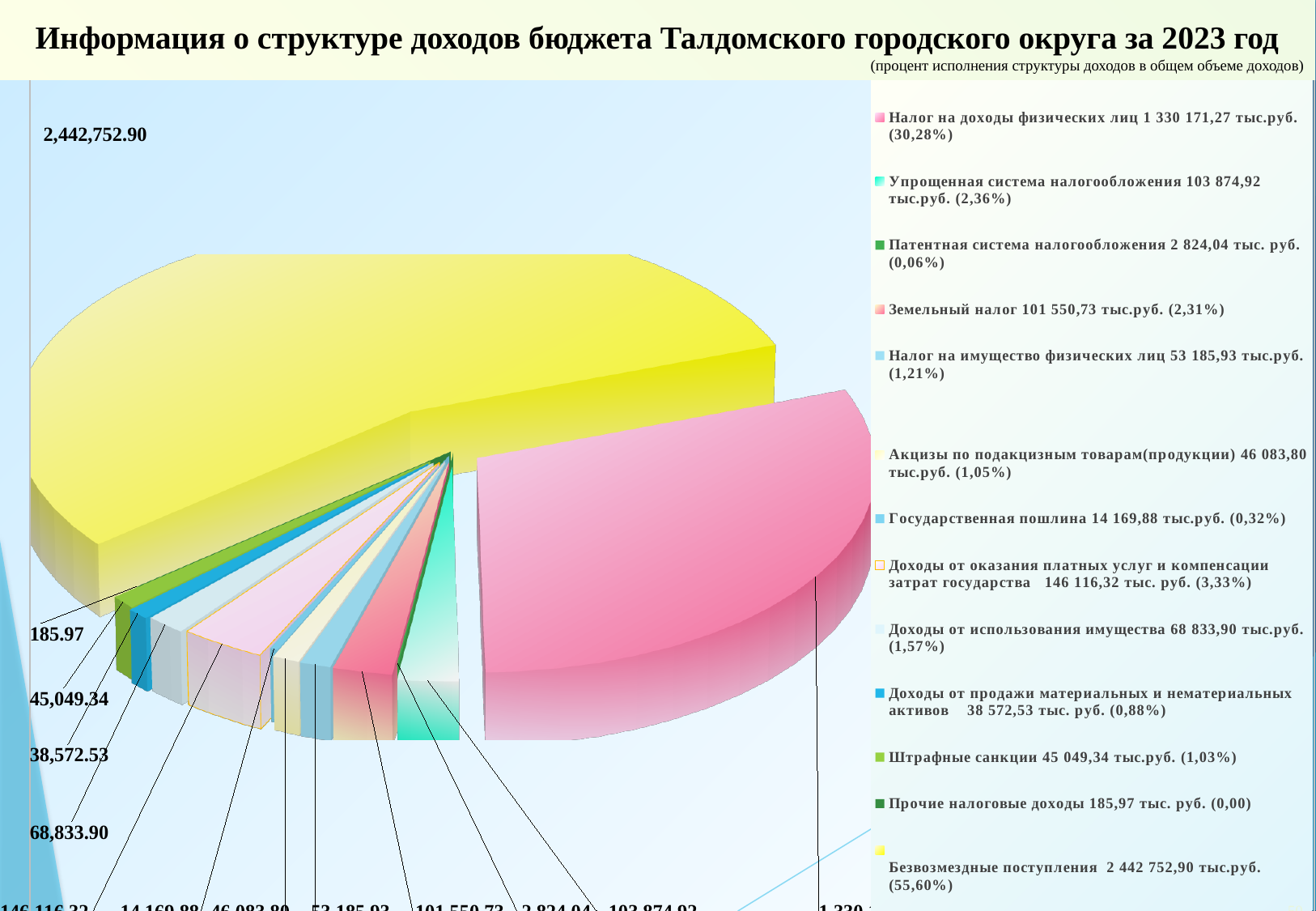
What is the difference between the values for Штрафные санкции and Доходы от продажи материальных и нематериальных активов? 6,476.81 How many categories does the legend list? 13 What is the value shown for Штрафные санкции? 45,049.34 Which is larger: the value for Доходы от использования имущества or the value for Акцизы по подакцизным товарам(продукции)? Доходы от использования имущества What is the value shown for Безвозмездные поступления? 2,442,752.90 Which category has the smallest share of the pie? Прочие налоговые доходы What is the value shown for Государственная пошлина? 14,169.88 What is the value shown for Доходы от использования имущества? 68,833.90 Which category has the largest share of the pie? Безвозмездные поступления What share of the pie does Безвозмездные поступления represent, according to the legend? 55,60% What share of the pie does Налог на доходы физических лиц represent, according to the legend? 30,28% What kind of chart is shown on the slide? pie chart